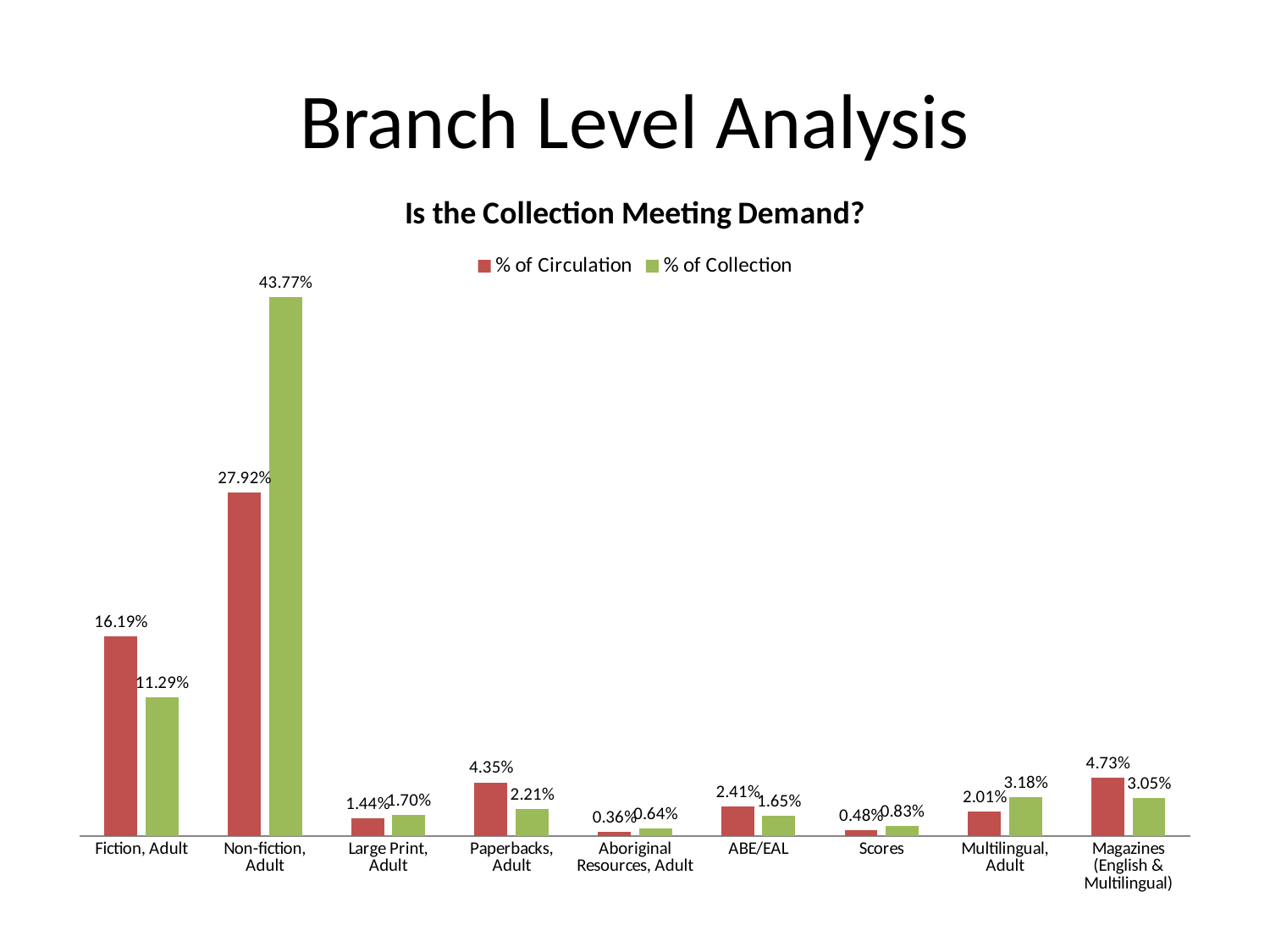
What is the % of Collection for Fiction, Adult? 11.29% How many categories are shown on the x axis? 9 What is the % of Circulation for Non-fiction, Adult? 27.92% Which category has the lowest % of Circulation? Aboriginal Resources, Adult What is the % of Collection for Non-fiction, Adult? 43.77% What is the % of Circulation for Aboriginal Resources, Adult? 0.36% For Paperbacks, Adult, which is larger: % of Circulation or % of Collection? % of Circulation How many series does the legend list? 2 What is the % of Circulation for Magazines (English & Multilingual)? 4.73% What type of chart is shown on the slide? Bar chart Which category has the highest % of Collection? Non-fiction, Adult What is the difference between the % of Collection and the % of Circulation for Non-fiction, Adult? 15.85%